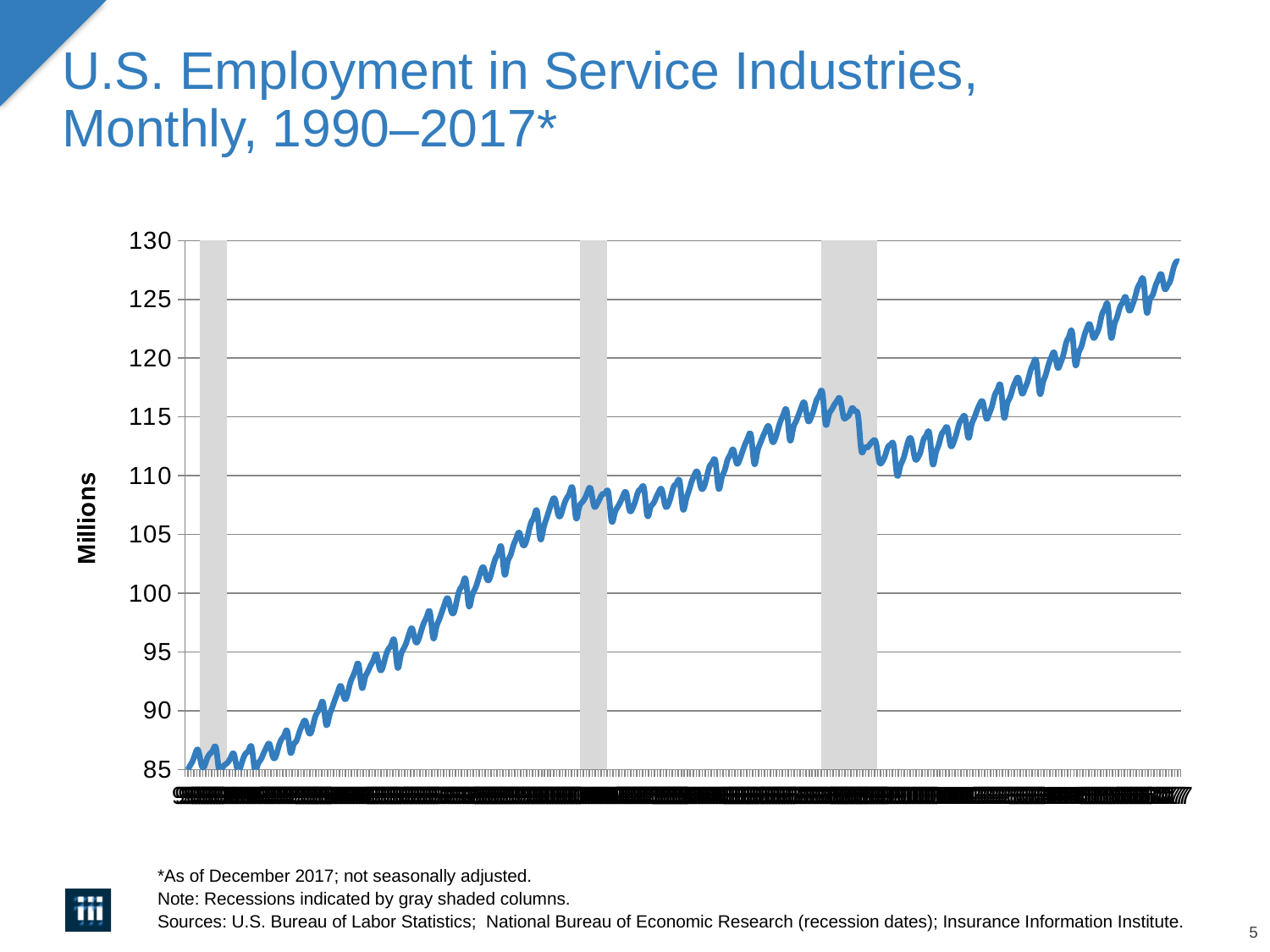
Is the peak reached just before the third gray shaded column greater or less than 115? greater Is the value at the left end of the line (start of 1990) greater or less than 90? less How many gray shaded recession columns are shown on the chart? 3 What kind of chart is shown on the slide? line chart What is the highest value shown on the vertical axis? 130 What is the label on the vertical axis of the chart? Millions What is the title of the chart? U.S. Employment in Service Industries, Monthly, 1990–2017* Overall, do the values rise or fall from left to right along the x axis? rise Is the value at the right end of the line greater or less than 130? less